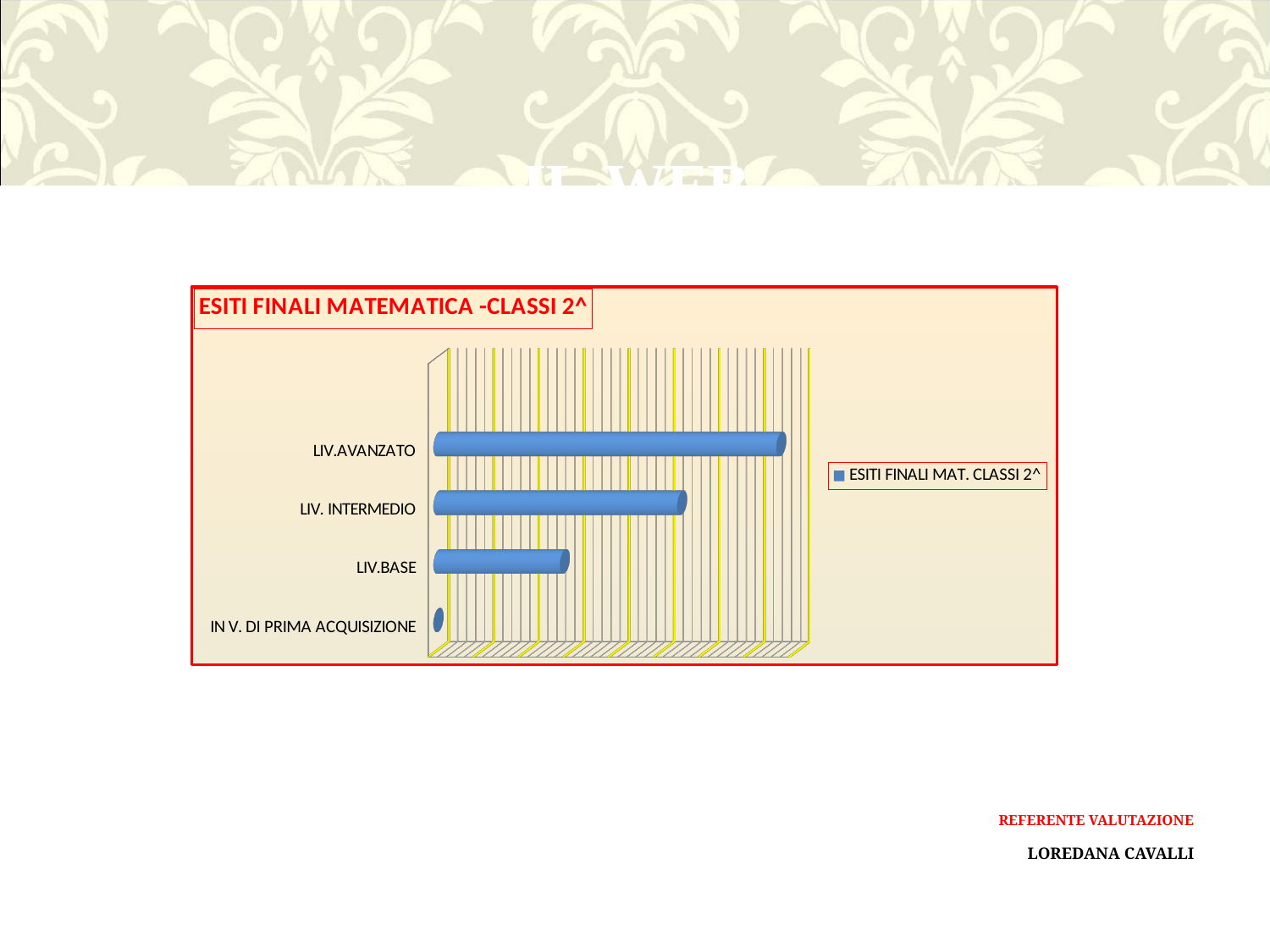
Do the bar values rise or fall going from LIV.AVANZATO at the top to IN V. DI PRIMA ACQUISIZIONE at the bottom? fall Which is larger, the value for LIV.AVANZATO or the value for LIV. INTERMEDIO? LIV.AVANZATO What kind of chart is shown on the slide? bar chart Which category has the highest value? LIV.AVANZATO What is the title of the chart? ESITI FINALI MATEMATICA -CLASSI 2^ Which is larger, the value for LIV. INTERMEDIO or the value for LIV.BASE? LIV. INTERMEDIO How many categories are shown in the chart? 4 How many series does the legend list? 1 What is the name of the series listed in the legend? ESITI FINALI MAT. CLASSI 2^ Which category has the lowest value? IN V. DI PRIMA ACQUISIZIONE Which is larger, the value for LIV.BASE or the value for IN V. DI PRIMA ACQUISIZIONE? LIV.BASE